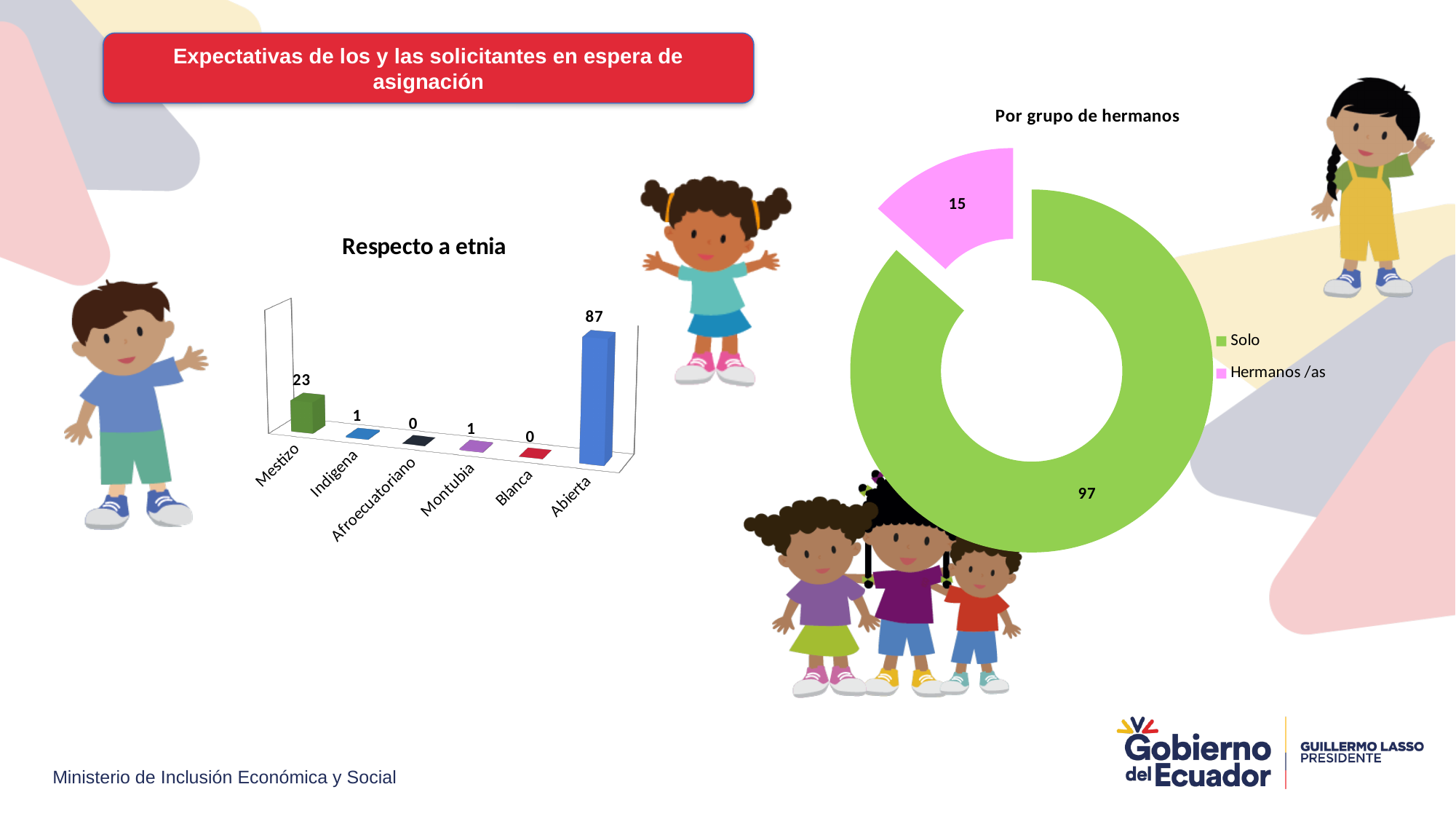
In the 'Respecto a etnia' chart, what is the difference between the values for Abierta and Mestizo? 64 In the 'Respecto a etnia' chart, which category has the highest value? Abierta In the 'Por grupo de hermanos' chart, what is the value for Hermanos /as? 15 What kind of chart is 'Respecto a etnia'? Bar chart In the 'Por grupo de hermanos' chart, which category is larger, Solo or Hermanos /as? Solo In the 'Respecto a etnia' chart, what is the value for Mestizo? 23 In the 'Respecto a etnia' chart, how many categories are shown? 6 In the 'Respecto a etnia' chart, what is the value for Abierta? 87 In the 'Por grupo de hermanos' chart, what is the total of the two values shown? 112 In the 'Por grupo de hermanos' chart, what is the value for Solo? 97 In the 'Respecto a etnia' chart, which categories have a value of 0? Afroecuatoriano and Blanca What kind of chart is 'Por grupo de hermanos'? Doughnut chart